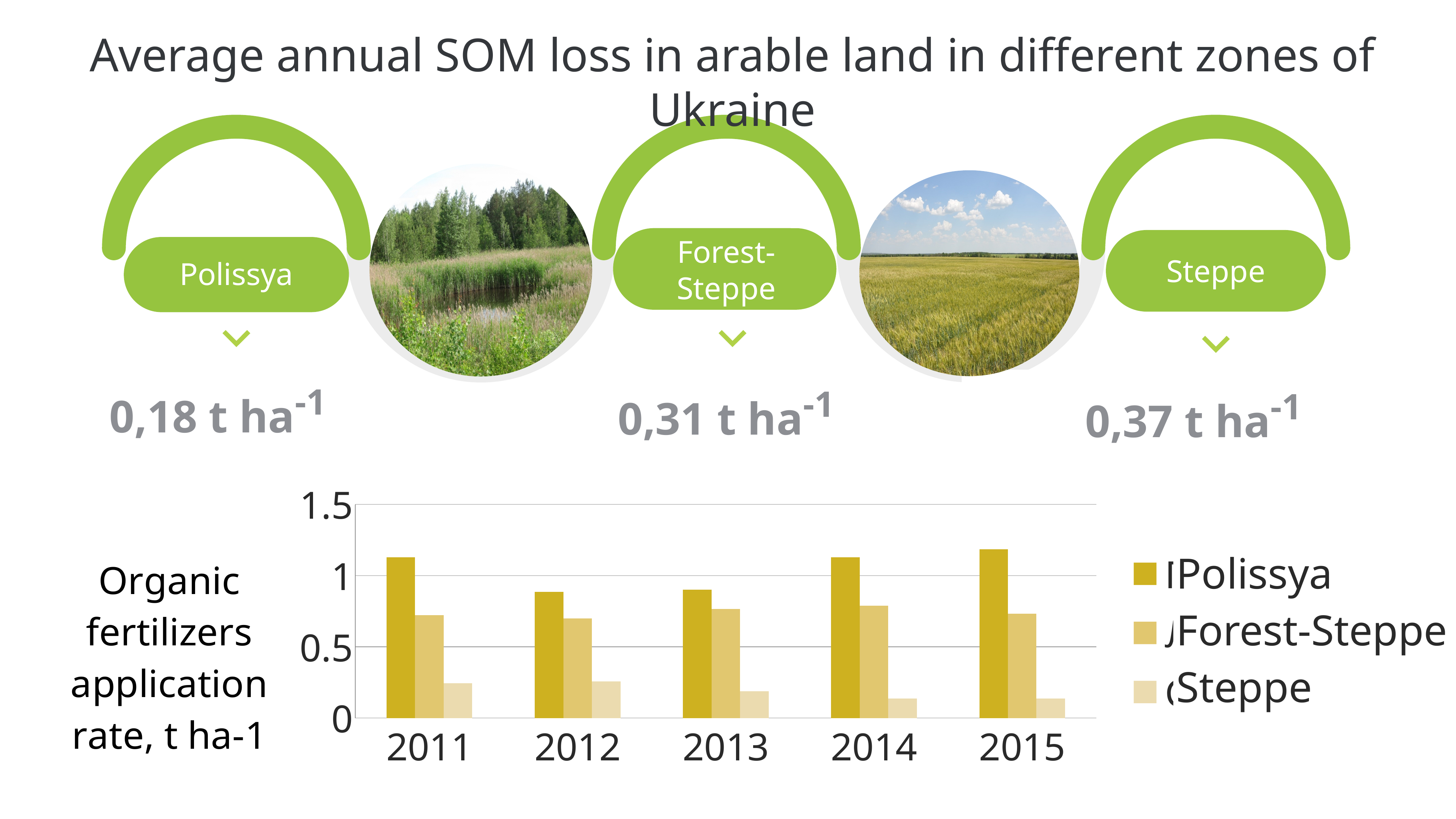
How many series does the legend of the bar chart list? 3 In which year is the Polissya bar the highest? 2015 Is the Polissya value for 2011 greater or less than 1? greater How many years are shown on the x axis of the bar chart? 5 In 2013, which is larger: the Polissya bar or the Steppe bar? Polissya Is the Steppe value for 2011 greater or less than 0.5? less Does the Steppe value rise or fall from 2012 to 2015? fall Which series in the bar chart has the highest bar in every year? Polissya Is the Forest-Steppe value for 2014 greater or less than 0.5? greater What is the label on the left side of the bar chart describing the plotted quantity? Organic fertilizers application rate, t ha-1 What kind of chart is shown at the bottom of the slide? bar chart